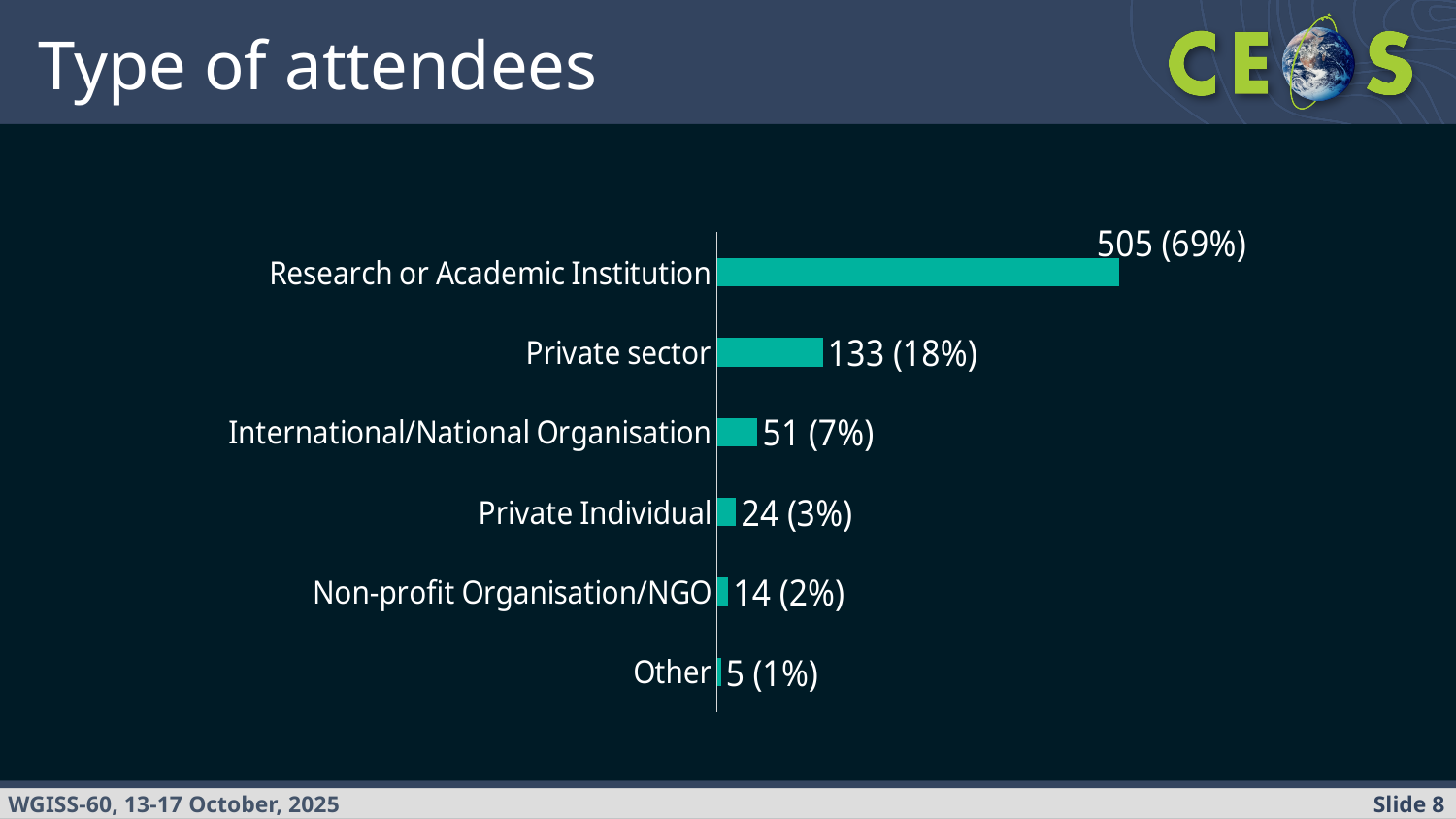
What colour are the bars in the chart? Teal What is the value for Private sector? 133 (18%) What is the total number of attendees across all categories? 732 What is the title of the slide? Type of attendees How many attendees are from an International/National Organisation? 51 What percentage of attendees are Private Individuals? 3% What is the difference between the number of attendees from Research or Academic Institution and from Private sector? 372 Which category has the highest value? Research or Academic Institution Which category has the lowest value? Other What kind of chart is shown on the slide? Bar chart Which is larger, the value for Private Individual or the value for Non-profit Organisation/NGO? Private Individual How many categories are shown in the chart? 6